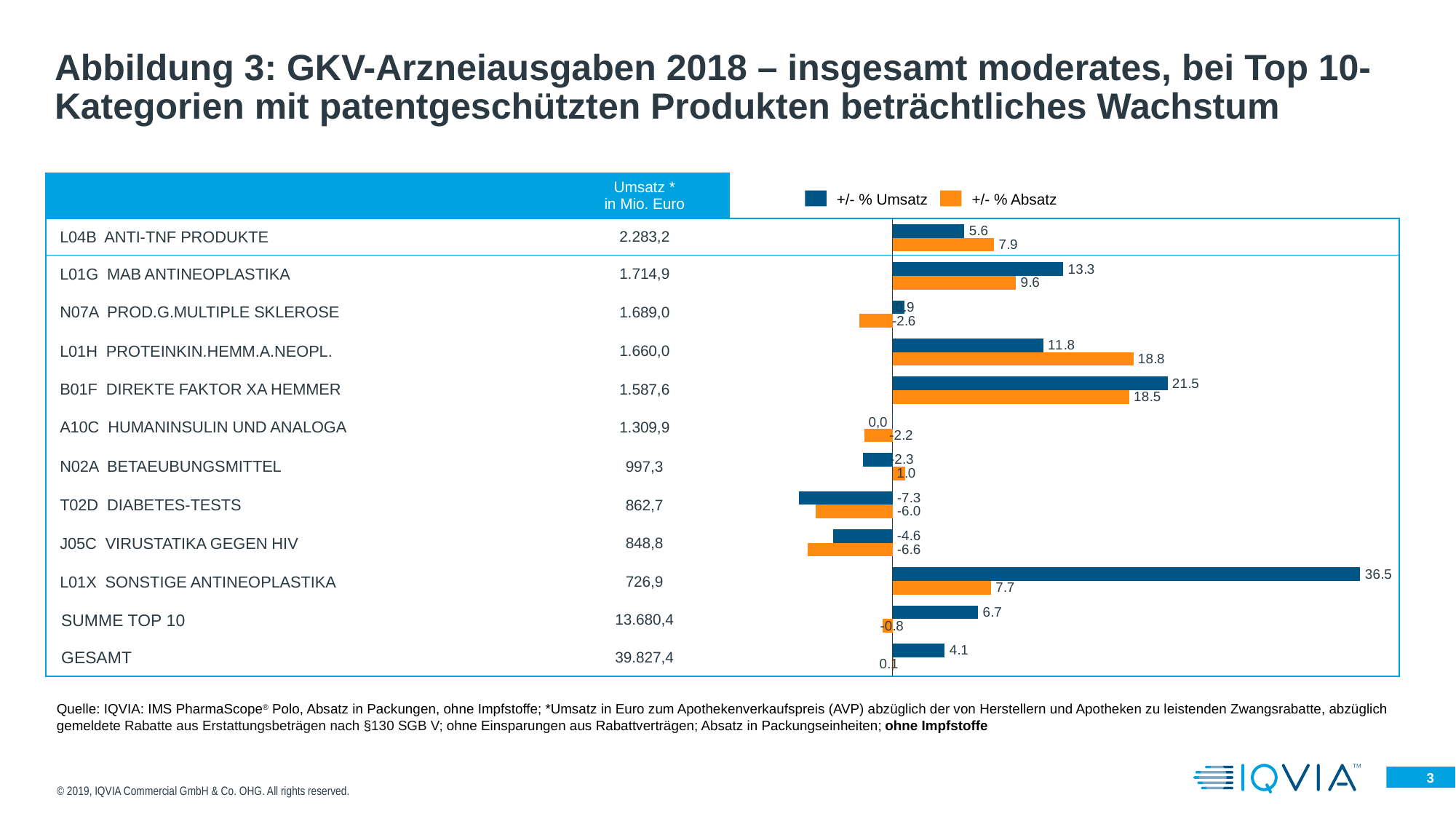
Which category has the highest +/- % Umsatz value? L01X SONSTIGE ANTINEOPLASTIKA Which category has the lowest +/- % Absatz value? J05C VIRUSTATIKA GEGEN HIV What is the +/- % Umsatz value for T02D DIABETES-TESTS? -7.3 What is the difference between the +/- % Umsatz and +/- % Absatz values for B01F DIREKTE FAKTOR XA HEMMER? 3.0 What kind of chart is shown on the slide? Bar chart Which is larger for L01G MAB ANTINEOPLASTIKA: the +/- % Umsatz value or the +/- % Absatz value? +/- % Umsatz How many rows (categories) are plotted in the chart, including SUMME TOP 10 and GESAMT? 12 Which colour represents the +/- % Absatz series in the chart? Orange How many series does the chart legend list? 2 What is the +/- % Umsatz value for L01X SONSTIGE ANTINEOPLASTIKA? 36.5 What is the +/- % Absatz value for L01H PROTEINKIN.HEMM.A.NEOPL.? 18.8 What is the +/- % Absatz value for SUMME TOP 10? -0.8